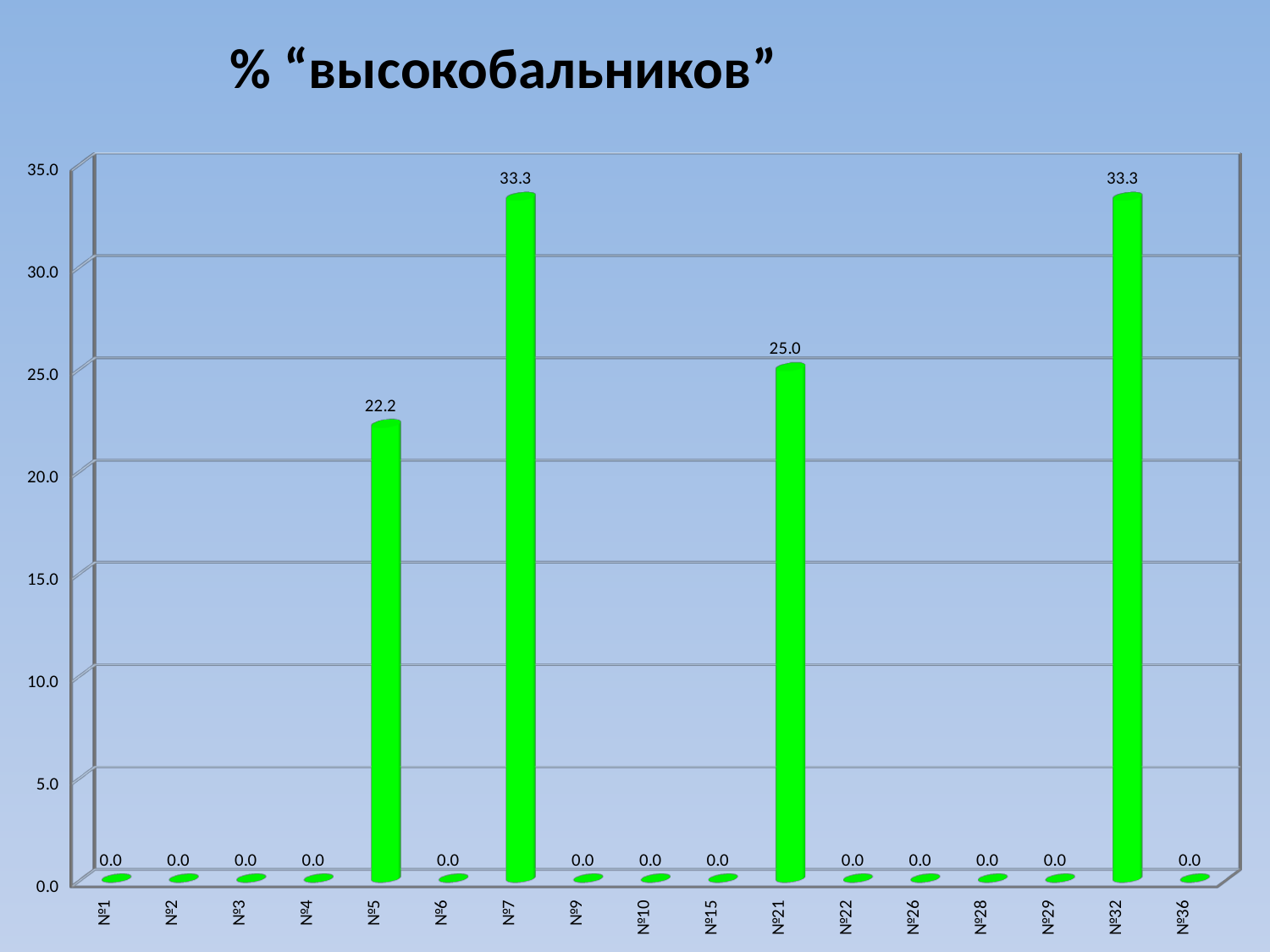
Which has the larger value, №5 or №21? №21 What is the title of the chart? % "высокобальников" What is the value for №5? 22.2 How many categories are shown on the x axis? 17 What is the value for №32? 33.3 What is the value for №1? 0.0 What is the value for №21? 25.0 What is the difference between the values for №21 and №5? 2.8 How many categories have a value greater than 0.0? 4 What is the difference between the values for №7 and №21? 8.3 What kind of chart is shown on the slide? bar chart What is the value for №7? 33.3